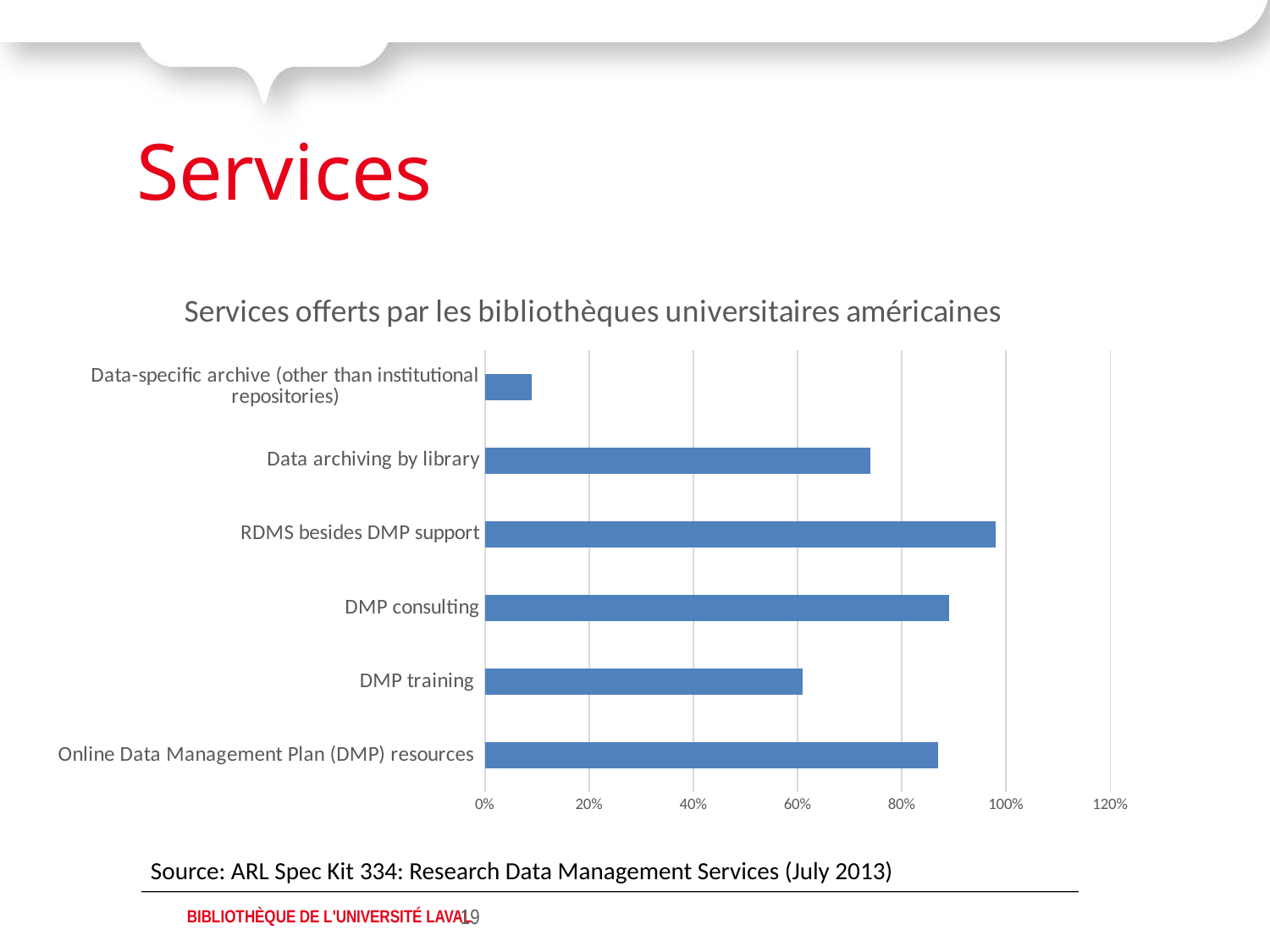
Which service has the highest value in the chart? RDMS besides DMP support Is the value for DMP training greater or less than 80%? less Is the value for Data-specific archive (other than institutional repositories) greater or less than 20%? less What is the highest value shown on the horizontal axis of the chart? 120% What kind of chart is shown on the slide? bar chart Which service has the lowest value in the chart? Data-specific archive (other than institutional repositories) Is the value for RDMS besides DMP support greater or less than 80%? greater Which is larger, the value for RDMS besides DMP support or the value for DMP consulting? RDMS besides DMP support Which is larger, the value for DMP training or the value for Data archiving by library? Data archiving by library How many service categories are plotted in the chart? 6 What is the title of the chart? Services offerts par les bibliothèques universitaires américaines